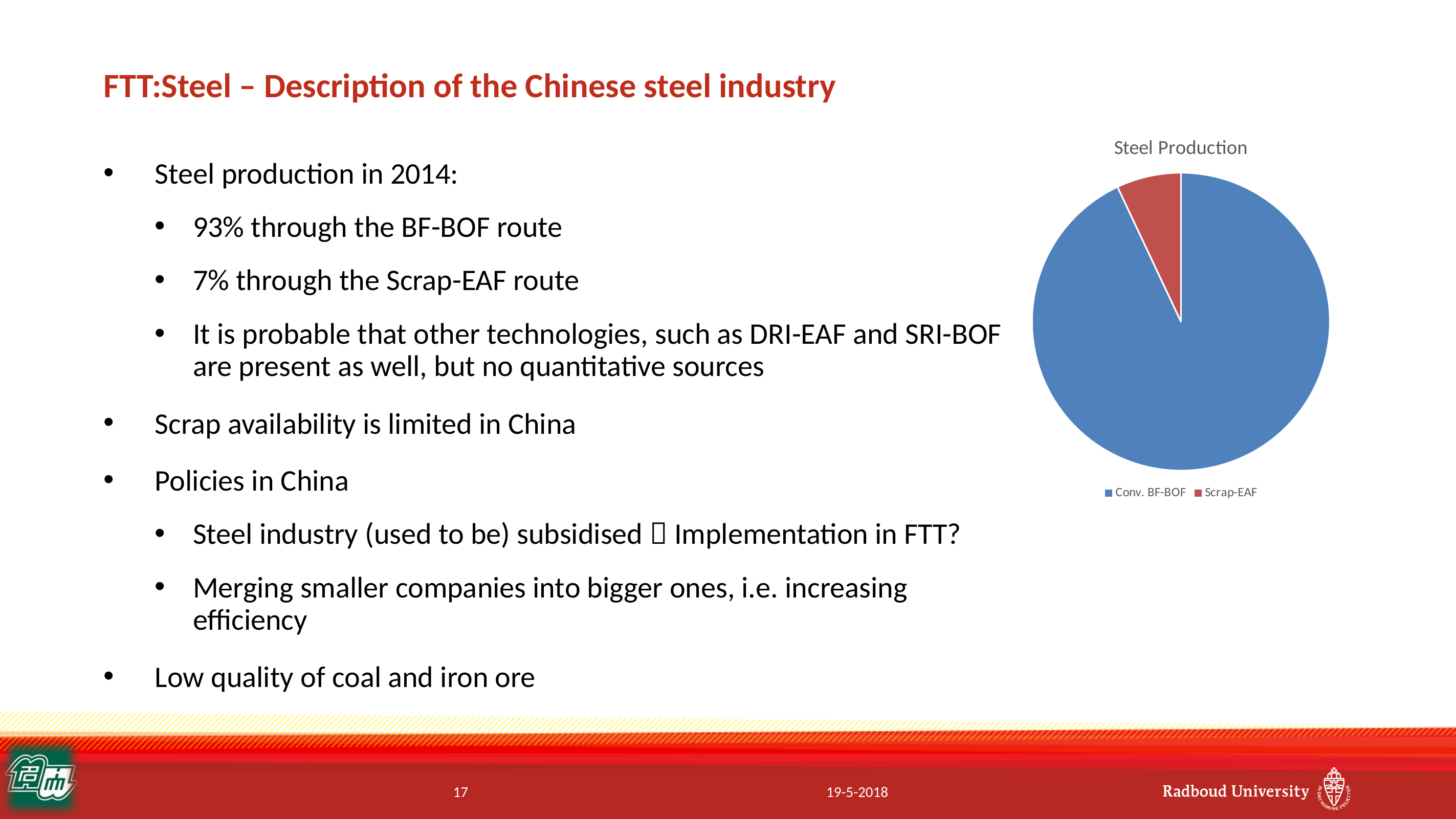
What kind of chart is shown on the slide? pie chart Which category has the smallest slice in the Steel Production pie chart? Scrap-EAF What colour is the Scrap-EAF slice in the Steel Production pie chart? red How many slices does the Steel Production pie chart have? 2 Which category has the largest slice in the Steel Production pie chart? Conv. BF-BOF How many entries does the legend of the Steel Production chart list? 2 Which slice is larger in the Steel Production pie chart, Conv. BF-BOF or Scrap-EAF? Conv. BF-BOF According to the slide, what share of steel production goes through the BF-BOF route shown as the blue slice? 93% What is the title of the chart? Steel Production According to the slide, what share of steel production goes through the Scrap-EAF route shown as the red slice? 7%